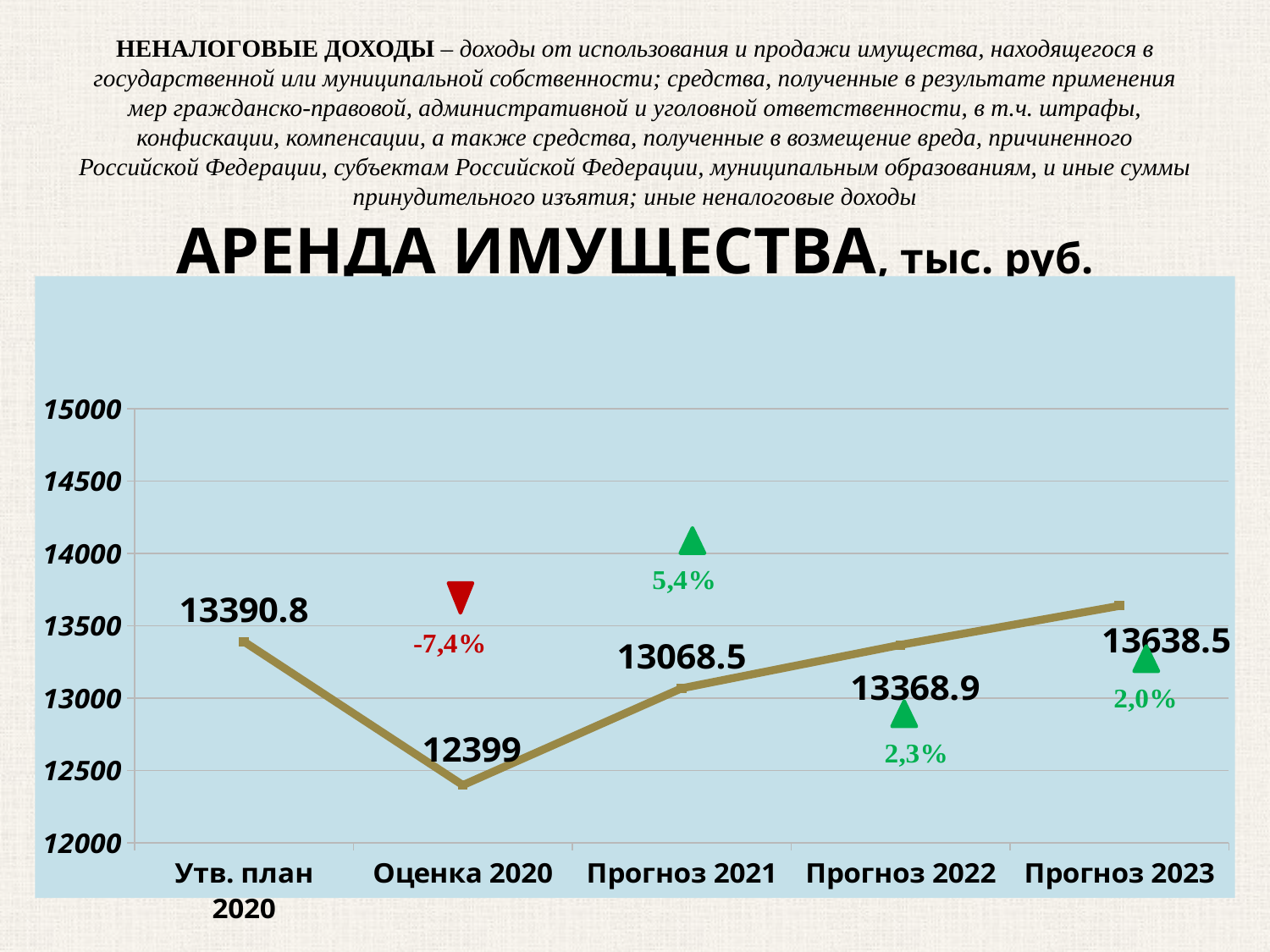
What is the value for Оценка 2020? 12399 What kind of chart is shown? line chart What percentage change is shown next to the red arrow above Оценка 2020? -7,4% What is the difference between the values for Прогноз 2023 and Прогноз 2022? 269.6 Which category has the highest value? Прогноз 2023 How many categories are plotted on the x axis? 5 Is the value for Прогноз 2021 greater or less than 13500? less Do the values rise or fall from Оценка 2020 to Прогноз 2023? rise What is the value for Прогноз 2023? 13638.5 Which is larger, the value for Утв. план 2020 or the value for Прогноз 2022? Утв. план 2020 What is the value for Утв. план 2020? 13390.8 Which category has the lowest value? Оценка 2020